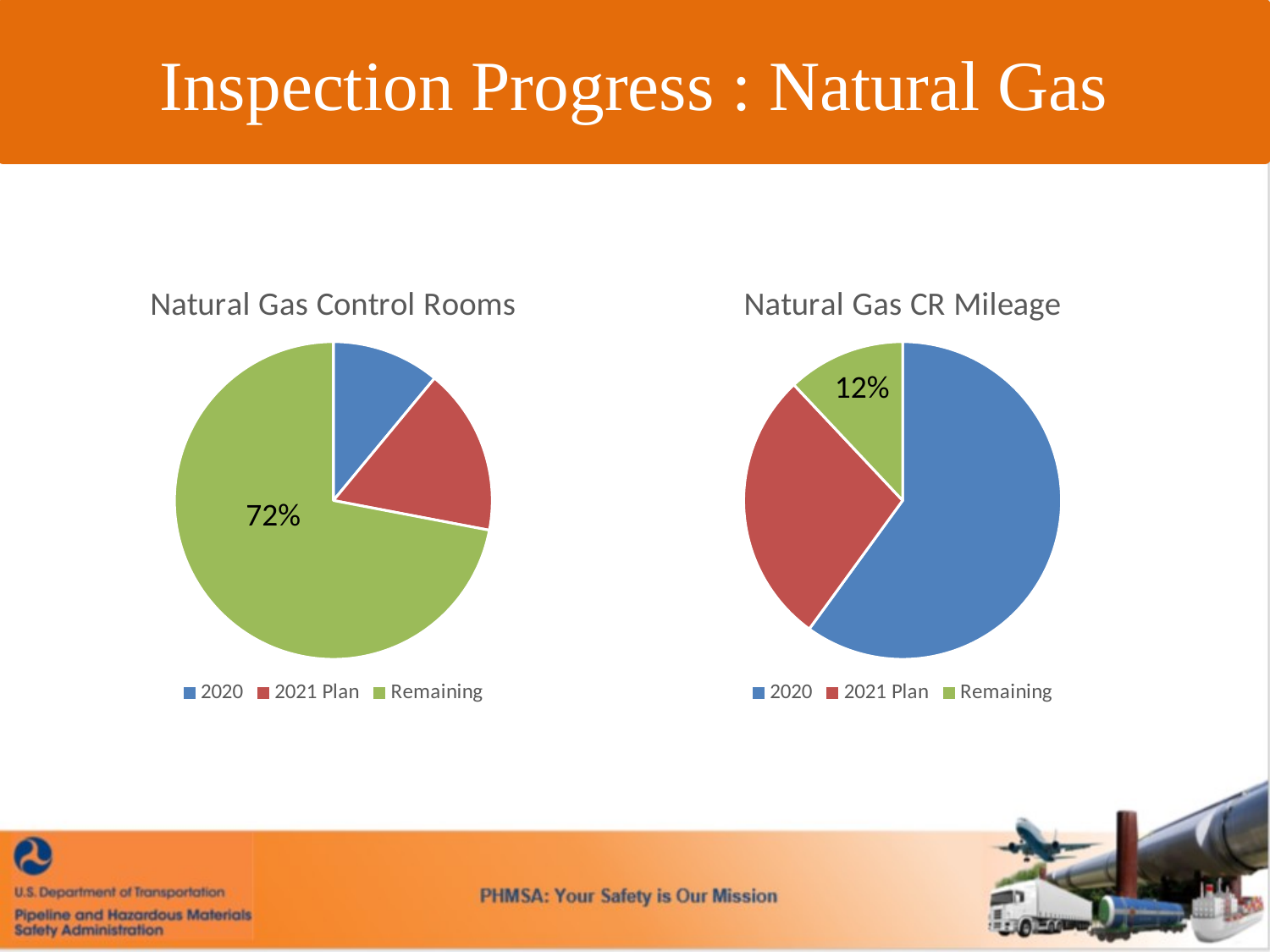
In the Natural Gas CR Mileage chart, which slice is larger, 2021 Plan or Remaining? 2021 Plan In the Natural Gas Control Rooms chart, which slice is larger, 2021 Plan or 2020? 2021 Plan In the Natural Gas Control Rooms chart, which category has the largest slice? Remaining How many entries does the legend of the Natural Gas CR Mileage chart list? 3 In the Natural Gas CR Mileage chart, which category has the largest slice? 2020 In the Natural Gas CR Mileage chart, which category has the smallest slice? Remaining In the Natural Gas Control Rooms chart, what colour is the Remaining slice? Green In the Natural Gas Control Rooms chart, what share of the pie is labelled for the Remaining slice? 72% How many slices does the Natural Gas Control Rooms pie chart have? 3 What kind of chart is the Natural Gas CR Mileage chart? Pie chart In the Natural Gas Control Rooms chart, which category has the smallest slice? 2020 In the Natural Gas CR Mileage chart, what share of the pie is labelled for the Remaining slice? 12%